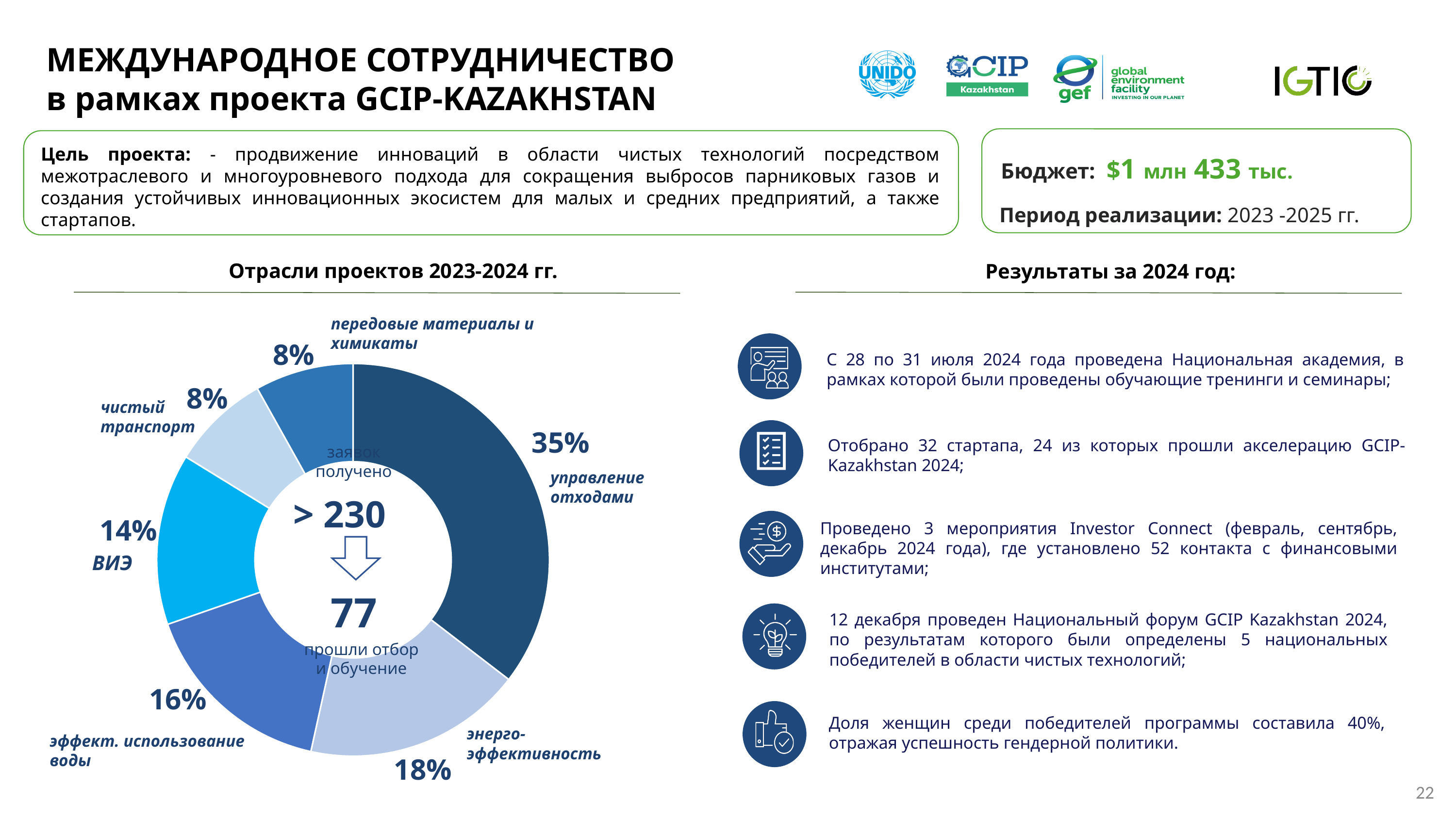
In the 'Отрасли проектов 2023-2024 гг.' chart, what is the value for 'энергоэффективность'? 18% According to the centre of the 'Отрасли проектов 2023-2024 гг.' chart, how many applicants passed selection and training ('прошли отбор и обучение')? 77 In the 'Отрасли проектов 2023-2024 гг.' chart, which is larger: 'ВИЭ' or 'эффект. использование воды'? эффект. использование воды In the 'Отрасли проектов 2023-2024 гг.' chart, which sector has the largest share? управление отходами In the 'Отрасли проектов 2023-2024 гг.' chart, what is the value for 'ВИЭ'? 14% In the 'Отрасли проектов 2023-2024 гг.' chart, which two sectors share the same value of 8%? чистый транспорт and передовые материалы и химикаты In the 'Отрасли проектов 2023-2024 гг.' chart, what is the value for 'эффект. использование воды'? 16% How many sectors are shown in the 'Отрасли проектов 2023-2024 гг.' chart? 6 In the 'Отрасли проектов 2023-2024 гг.' chart, what is the difference in percentage points between 'управление отходами' and 'энергоэффективность'? 17 percentage points In the 'Отрасли проектов 2023-2024 гг.' chart, what share does 'управление отходами' have? 35% What kind of chart is shown under the heading 'Отрасли проектов 2023-2024 гг.'? Pie chart (donut) In the 'Отрасли проектов 2023-2024 гг.' chart, what is the value for 'чистый транспорт'? 8%